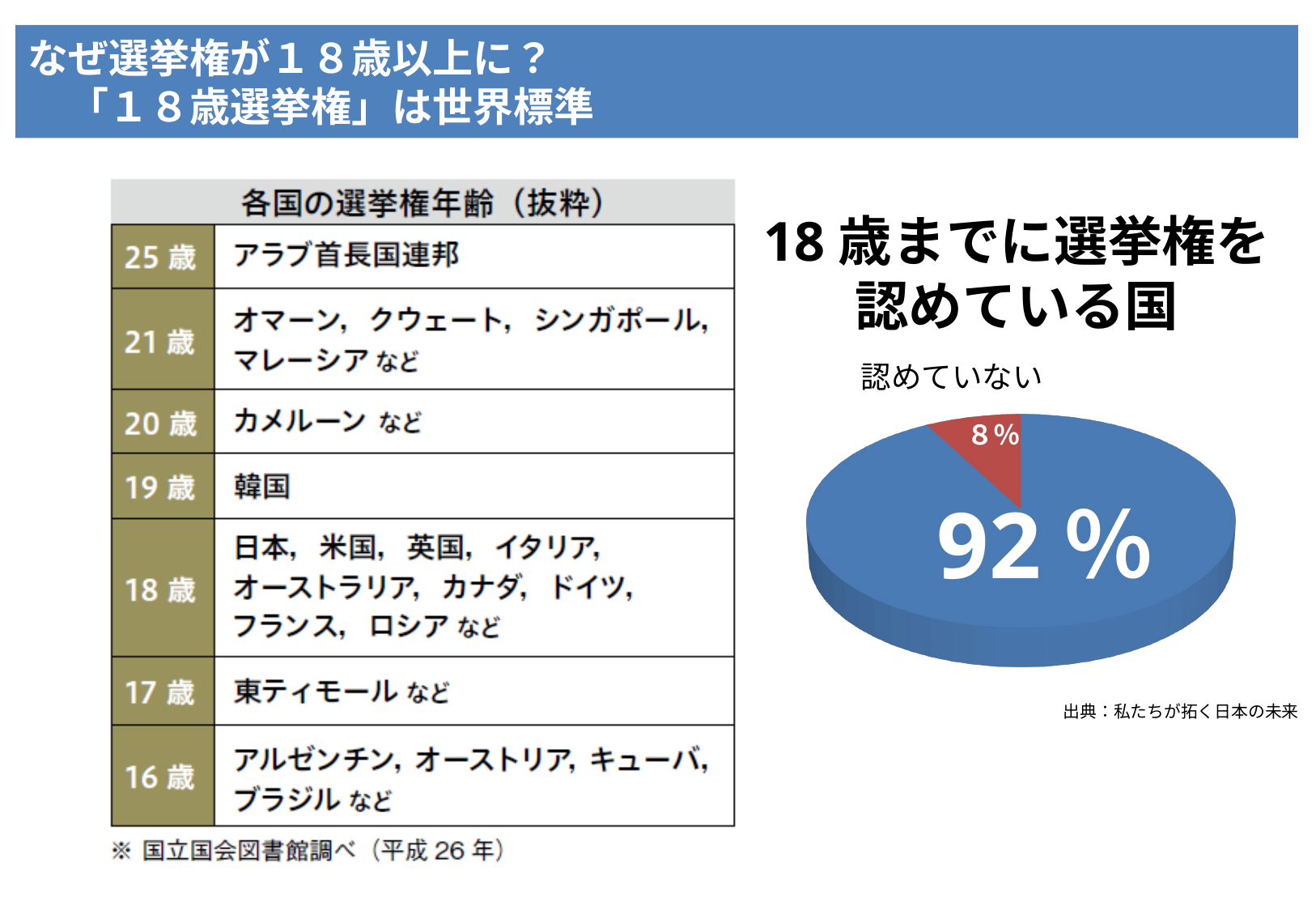
What share of the pie chart is labelled 92 %? 92 % What kind of chart is shown on the slide? pie chart What is the difference in percentage points between the 92 % slice and the 8 % slice in the pie chart? 84 percentage points Which slice of the pie chart is the largest? 92 % (countries granting voting rights by age 18) How many slices does the pie chart have? 2 Is the share of countries that do not grant voting rights by age 18 greater or less than 10%? less Which slice of the pie chart is the smallest? 認めていない (8 %) What is the title of the pie chart? 18歳までに選挙権を認めている国 What percentage does the slice labelled 認めていない represent in the pie chart? 8 % Is the 認めていない slice larger or smaller than the 92 % slice in the pie chart? smaller What colour is the 認めていない slice in the pie chart? red